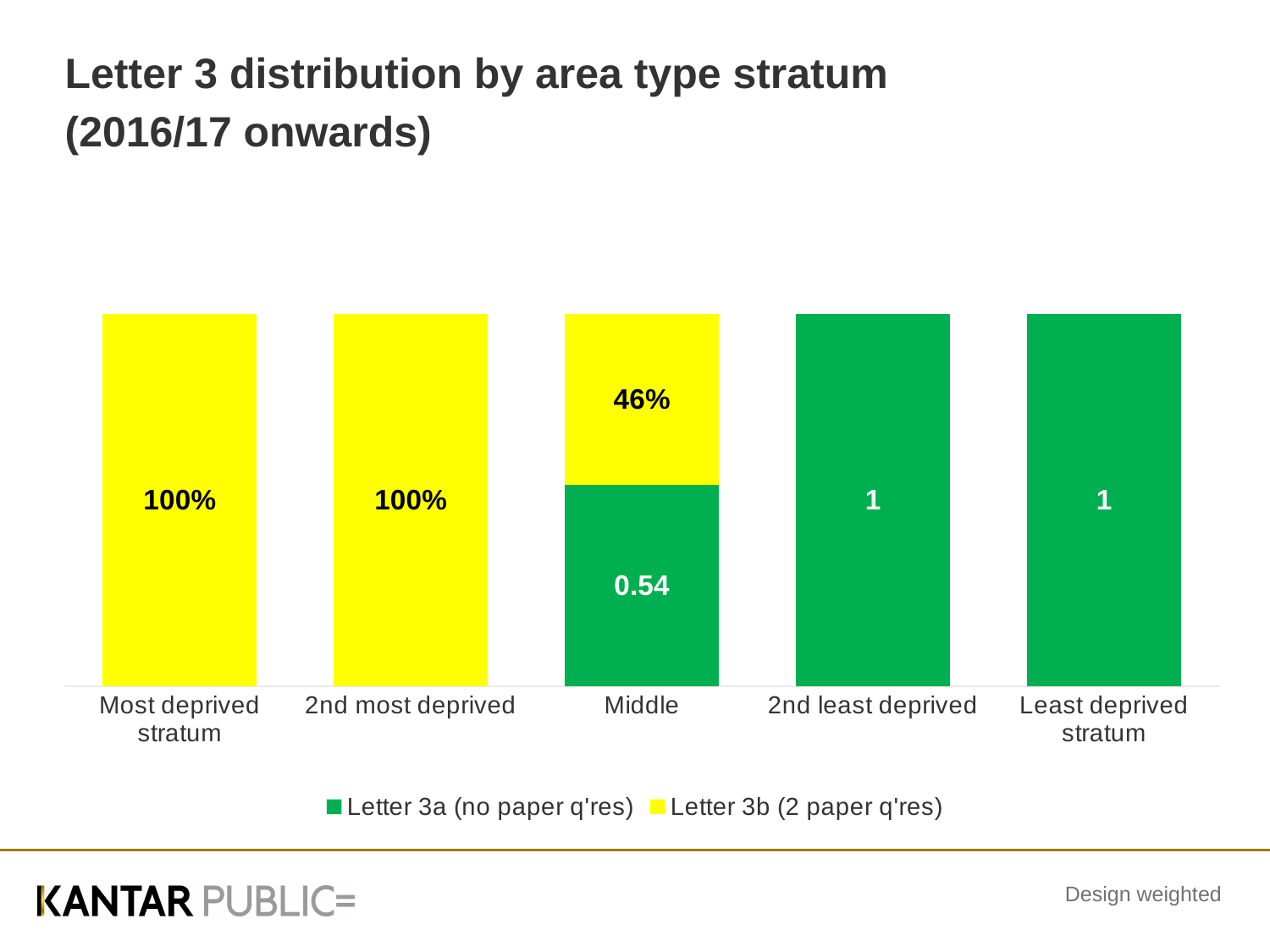
How many area type strata (categories) are shown on the x axis? 5 What is the value labelled for Letter 3b (2 paper q'res) in the Most deprived stratum? 100% What is the value labelled for Letter 3b (2 paper q'res) in the Middle stratum? 46% What is the value labelled for Letter 3a (no paper q'res) in the Middle stratum? 0.54 What is the title of the chart on the slide? Letter 3 distribution by area type stratum (2016/17 onwards) What is the value labelled for Letter 3a (no paper q'res) in the 2nd least deprived stratum? 1 How many series does the legend list? 2 In the Middle stratum, which is larger: the Letter 3a (no paper q'res) segment or the Letter 3b (2 paper q'res) segment? Letter 3a (no paper q'res) What kind of chart is shown on the slide? Stacked bar chart What is the value labelled for Letter 3a (no paper q'res) in the Least deprived stratum? 1 What is the value labelled for Letter 3b (2 paper q'res) in the 2nd most deprived stratum? 100% Which colour represents Letter 3b (2 paper q'res) in the chart? Yellow